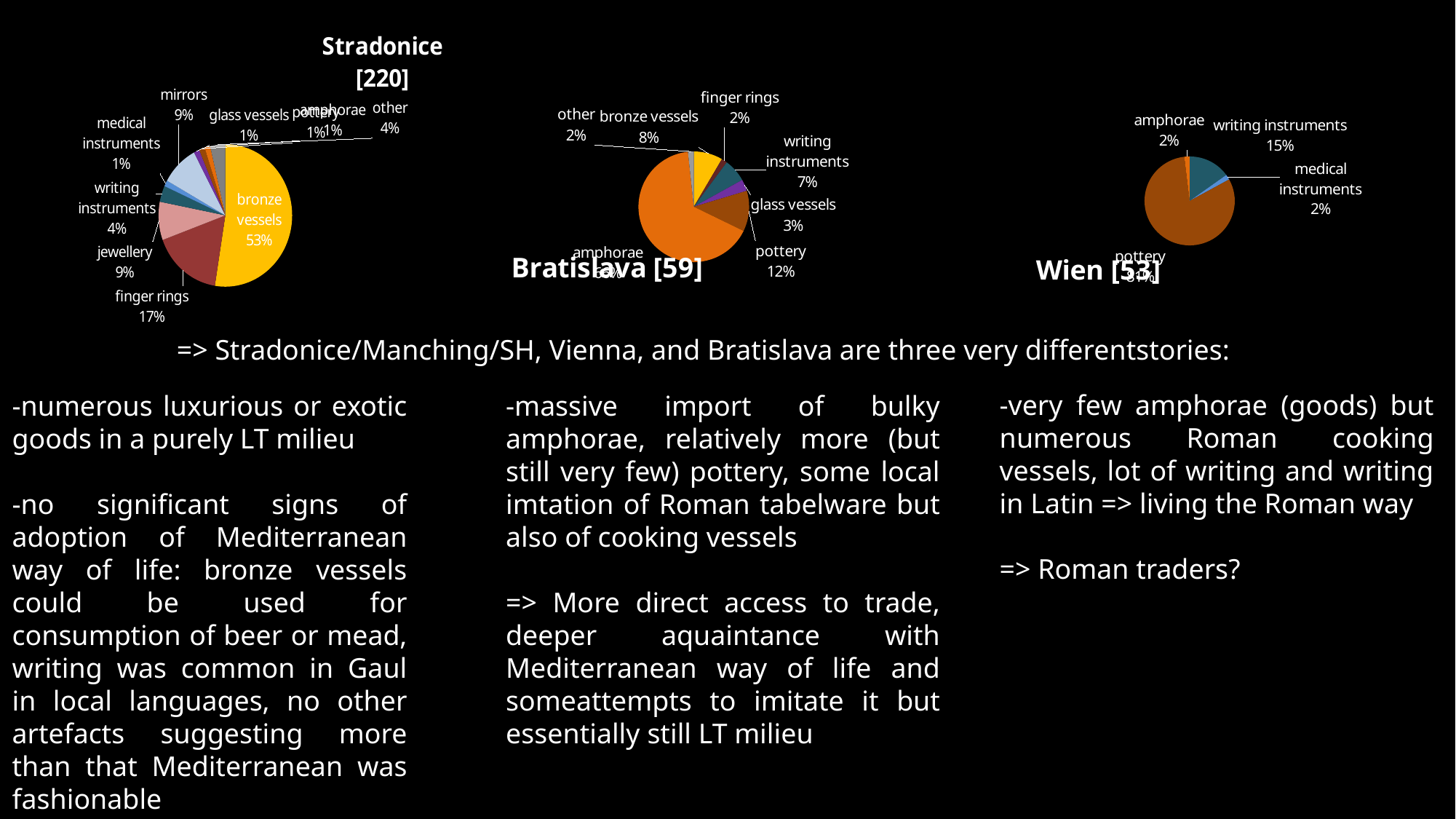
In the Bratislava [59] pie chart, what share does pottery have? 12% In the Stradonice [220] pie chart, which category has the largest share? bronze vessels In the Stradonice [220] pie chart, which is larger: the share of mirrors or the share of writing instruments? mirrors In the Stradonice [220] pie chart, what share do finger rings have? 17% In the Bratislava [59] pie chart, what is the difference between the shares of pottery and writing instruments? 5% In the Bratislava [59] pie chart, which category has the largest share? amphorae In the Wien [53] pie chart, what share do writing instruments have? 15% What type of chart is used for Stradonice [220]? pie chart In the Wien [53] pie chart, how many categories are shown? 4 In the Stradonice [220] pie chart, what share do bronze vessels have? 53% In the Bratislava [59] pie chart, what share do bronze vessels have? 8% In the Stradonice [220] pie chart, what is the difference between the shares of finger rings and jewellery? 8%